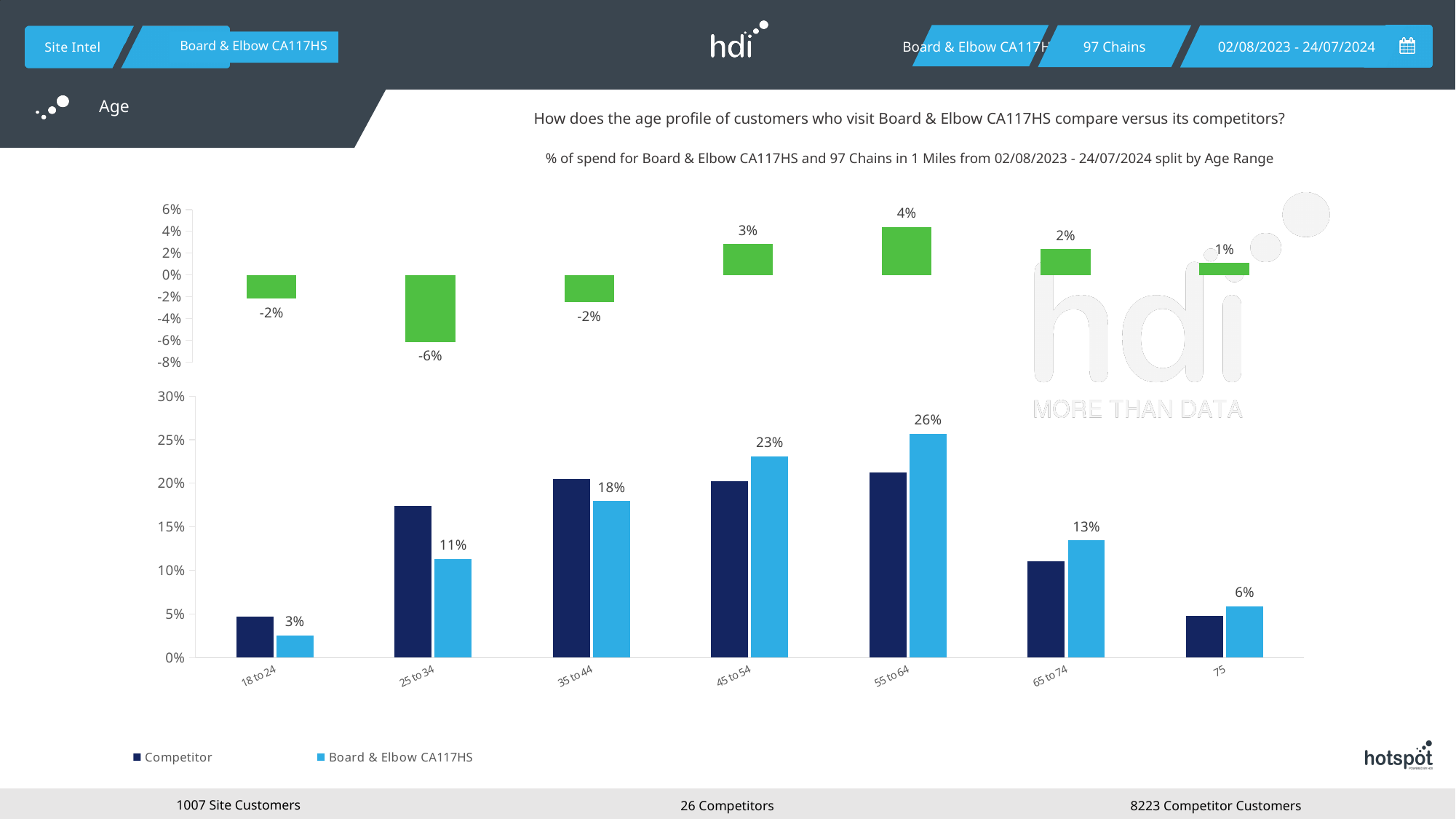
In the bottom chart, which age range has the highest value for Board & Elbow CA117HS? 55 to 64 In the bottom chart, what is the value for Board & Elbow CA117HS in the 18 to 24 age range? 3% In the bottom chart, for the 25 to 34 age range, which is larger: the Competitor bar or the Board & Elbow CA117HS bar? Competitor How many age range categories are shown on the x axis of the bottom chart? 7 In the bottom chart, is the Competitor value for 65 to 74 greater or less than 15%? less In the bottom chart, what is the difference between the Board & Elbow CA117HS values for 45 to 54 and 25 to 34? 12% In the bottom chart, is the Competitor value for 25 to 34 greater or less than 15%? greater In the top chart, which age range has the highest value? 55 to 64 In the bottom chart, what is the value for Board & Elbow CA117HS in the 55 to 64 age range? 26% In the top chart, what is the value for the 25 to 34 age range? -6% How many series does the legend of the bottom chart list? 2 In the bottom chart, which age range has the lowest value for Board & Elbow CA117HS? 18 to 24